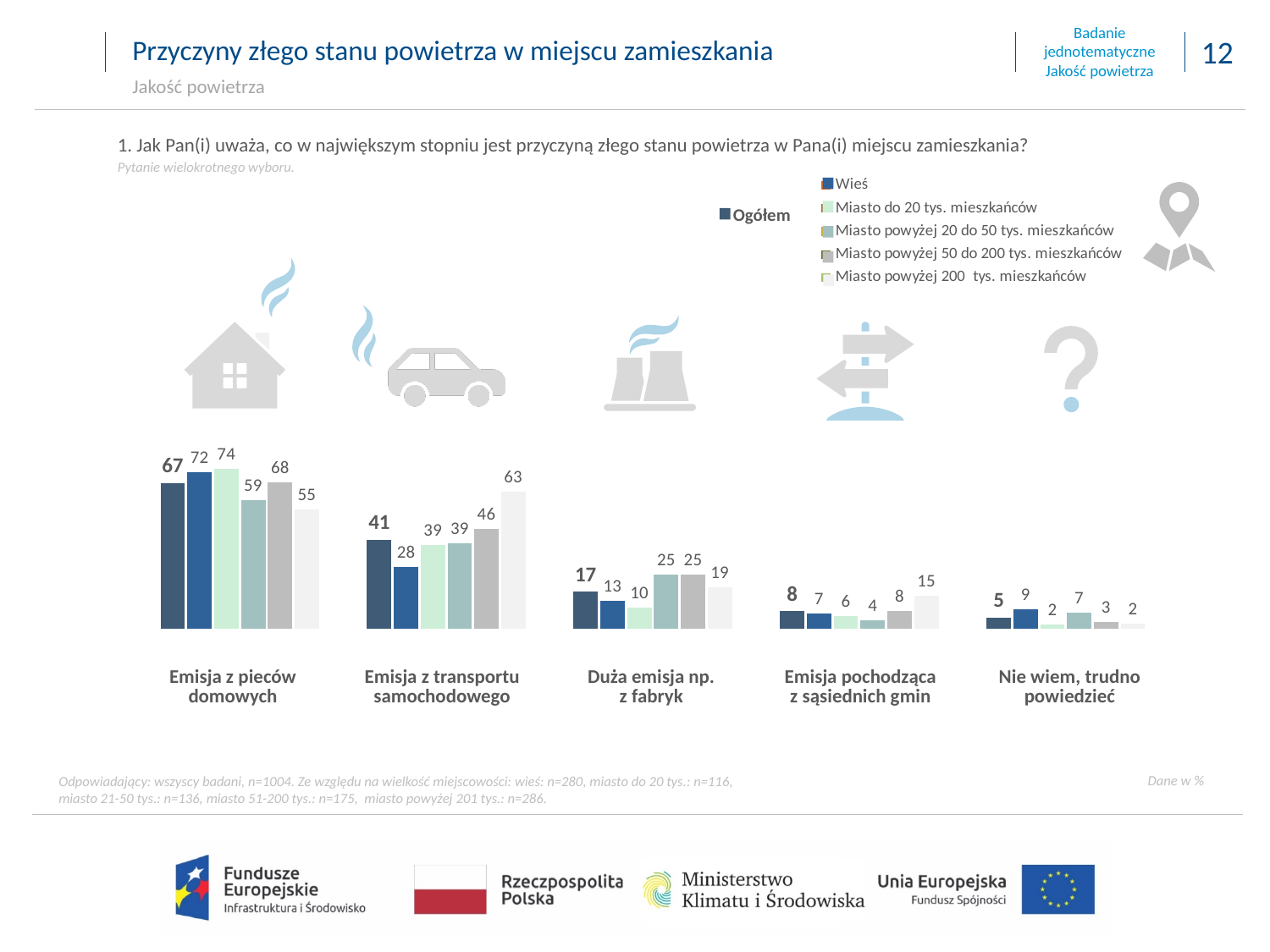
Do the Ogółem values rise or fall from "Emisja z pieców domowych" to "Nie wiem, trudno powiedzieć"? Fall What is the difference between the Ogółem values for "Emisja z pieców domowych" and "Emisja z transportu samochodowego"? 26 Which category has the lowest Ogółem value? Nie wiem, trudno powiedzieć Which legend entry is shown in the darkest blue colour? Ogółem What is the value for "Miasto powyżej 200 tys. mieszkańców" in the "Emisja z transportu samochodowego" category? 63 In the "Emisja pochodząca z sąsiednich gmin" category, which is larger: the value for Wieś or for "Miasto powyżej 200 tys. mieszkańców"? Miasto powyżej 200 tys. mieszkańców What is the Ogółem value for "Emisja z pieców domowych"? 67 What kind of chart is shown on the slide? Bar chart Which category has the highest Ogółem value? Emisja z pieców domowych How many series does the legend list? 6 How many response categories are shown on the chart? 5 What is the Wieś value for "Duża emisja np. z fabryk"? 13